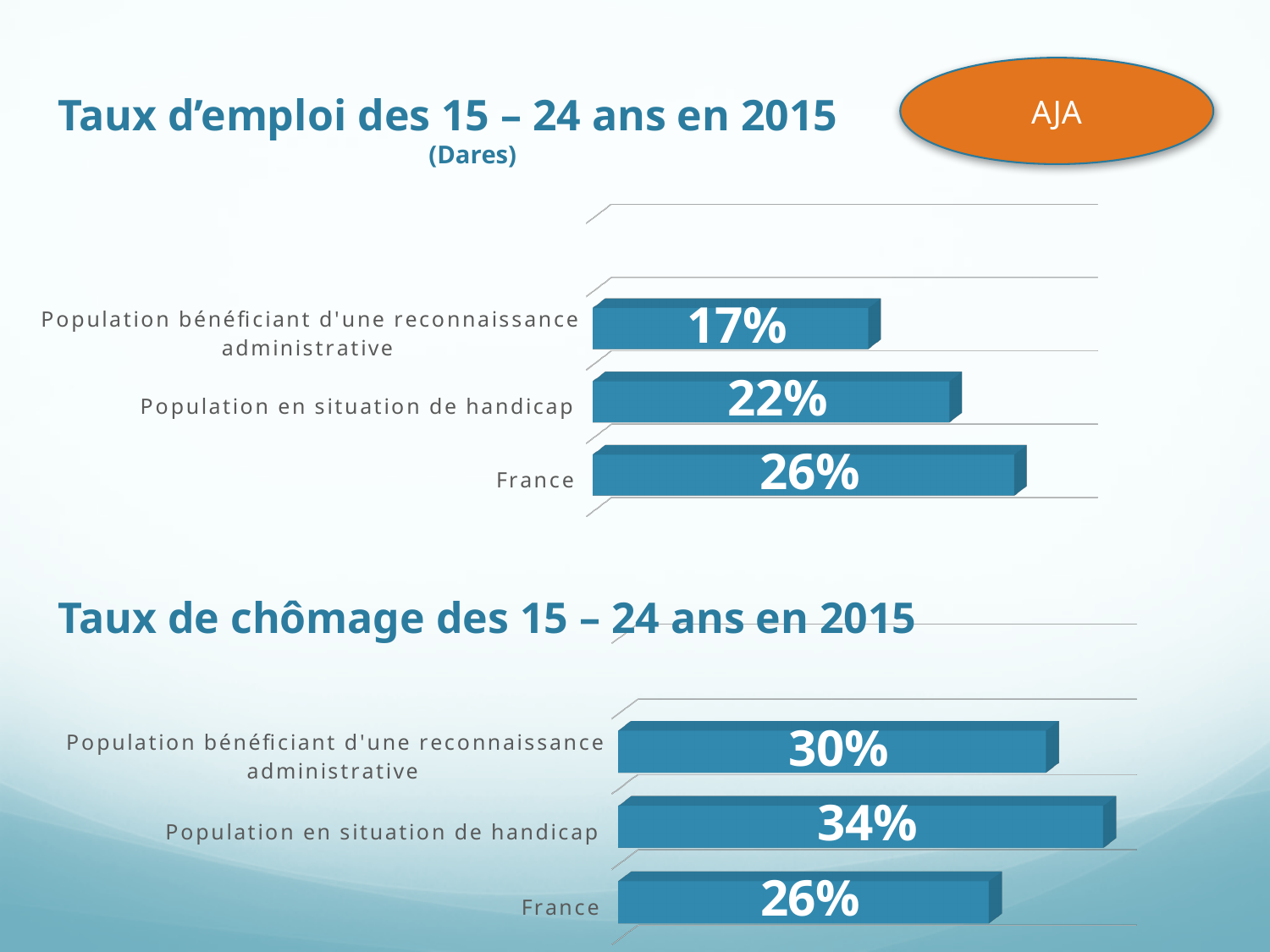
How many categories does the 'Taux de chômage des 15 – 24 ans en 2015' chart show? 3 In the 'Taux d'emploi des 15 – 24 ans en 2015' chart, what is the value for France? 26% In the 'Taux d'emploi des 15 – 24 ans en 2015' chart, which category has the lowest value? Population bénéficiant d'une reconnaissance administrative In the 'Taux de chômage des 15 – 24 ans en 2015' chart, which category has the lowest value? France In the 'Taux d'emploi des 15 – 24 ans en 2015' chart, which category has the highest value? France In the 'Taux de chômage des 15 – 24 ans en 2015' chart, what is the value for 'Population en situation de handicap'? 34% What type of chart is the 'Taux d'emploi des 15 – 24 ans en 2015' chart? Bar chart In the 'Taux de chômage des 15 – 24 ans en 2015' chart, which category has the highest value? Population en situation de handicap In the 'Taux d'emploi des 15 – 24 ans en 2015' chart, what is the difference between France and 'Population en situation de handicap'? 4% In the 'Taux d'emploi des 15 – 24 ans en 2015' chart, what is the value for 'Population bénéficiant d'une reconnaissance administrative'? 17% In the 'Taux de chômage des 15 – 24 ans en 2015' chart, what is the difference between 'Population en situation de handicap' and France? 8% In the 'Taux de chômage des 15 – 24 ans en 2015' chart, what is the value for 'Population bénéficiant d'une reconnaissance administrative'? 30%